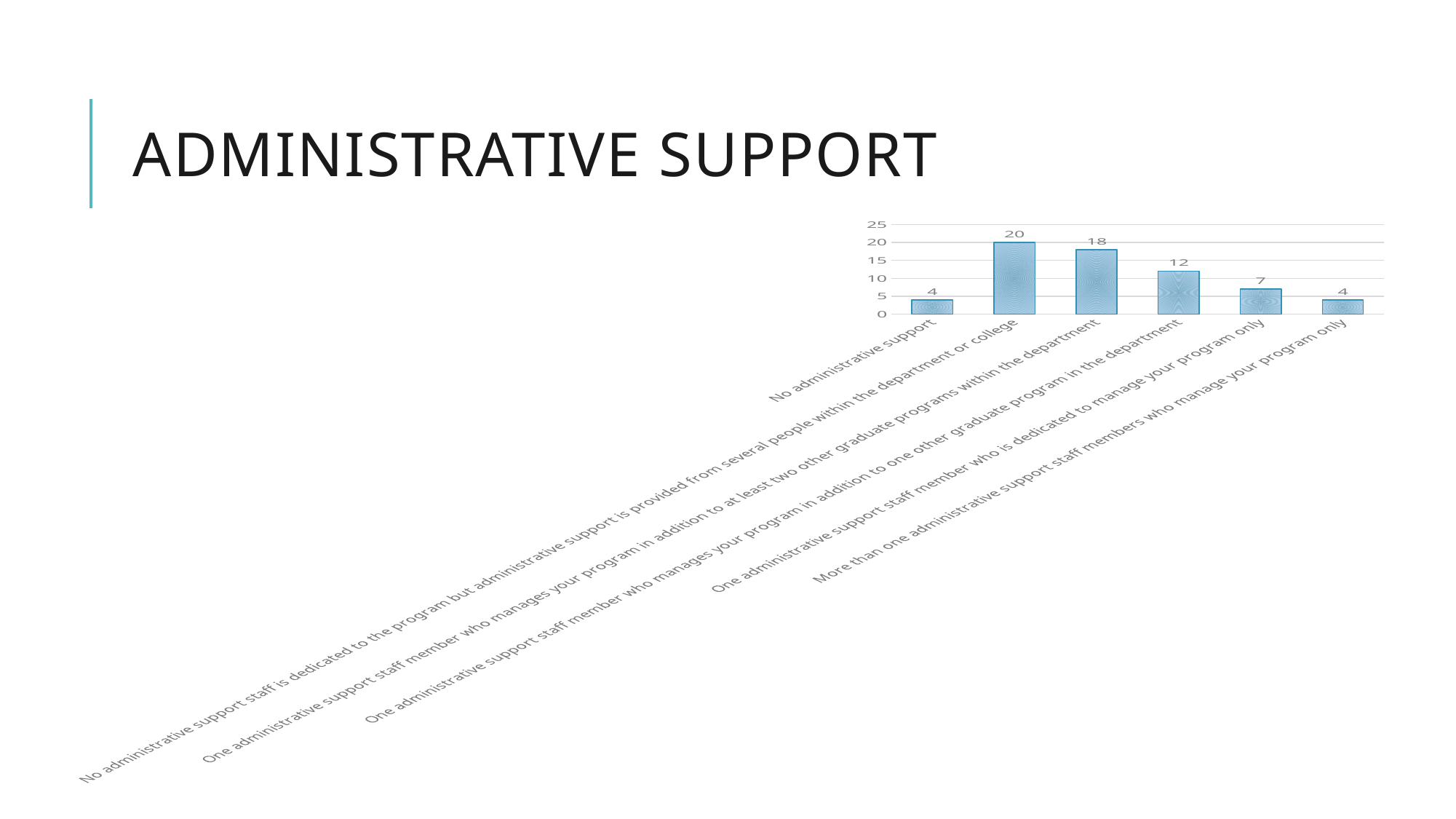
What is the value for "No administrative support staff is dedicated to the program but administrative support is provided from several people within the department or college"? 20 What is the value for "No administrative support"? 4 What is the value for "One administrative support staff member who manages your program in addition to one other graduate program in the department"? 12 Which is larger: the value for "One administrative support staff member who manages your program in addition to one other graduate program in the department" or the value for "One administrative support staff member who is dedicated to manage your program only"? One administrative support staff member who manages your program in addition to one other graduate program in the department What is the value for "One administrative support staff member who is dedicated to manage your program only"? 7 What is the value for "One administrative support staff member who manages your program in addition to at least two other graduate programs within the department"? 18 Which category has the highest value? No administrative support staff is dedicated to the program but administrative support is provided from several people within the department or college What is the title of the slide containing the chart? ADMINISTRATIVE SUPPORT What is the difference between the value for "One administrative support staff member who manages your program in addition to at least two other graduate programs within the department" and the value for "One administrative support staff member who is dedicated to manage your program only"? 11 How many categories are plotted in the chart? 6 What type of chart is shown on the slide? bar chart What is the value for "More than one administrative support staff members who manage your program only"? 4